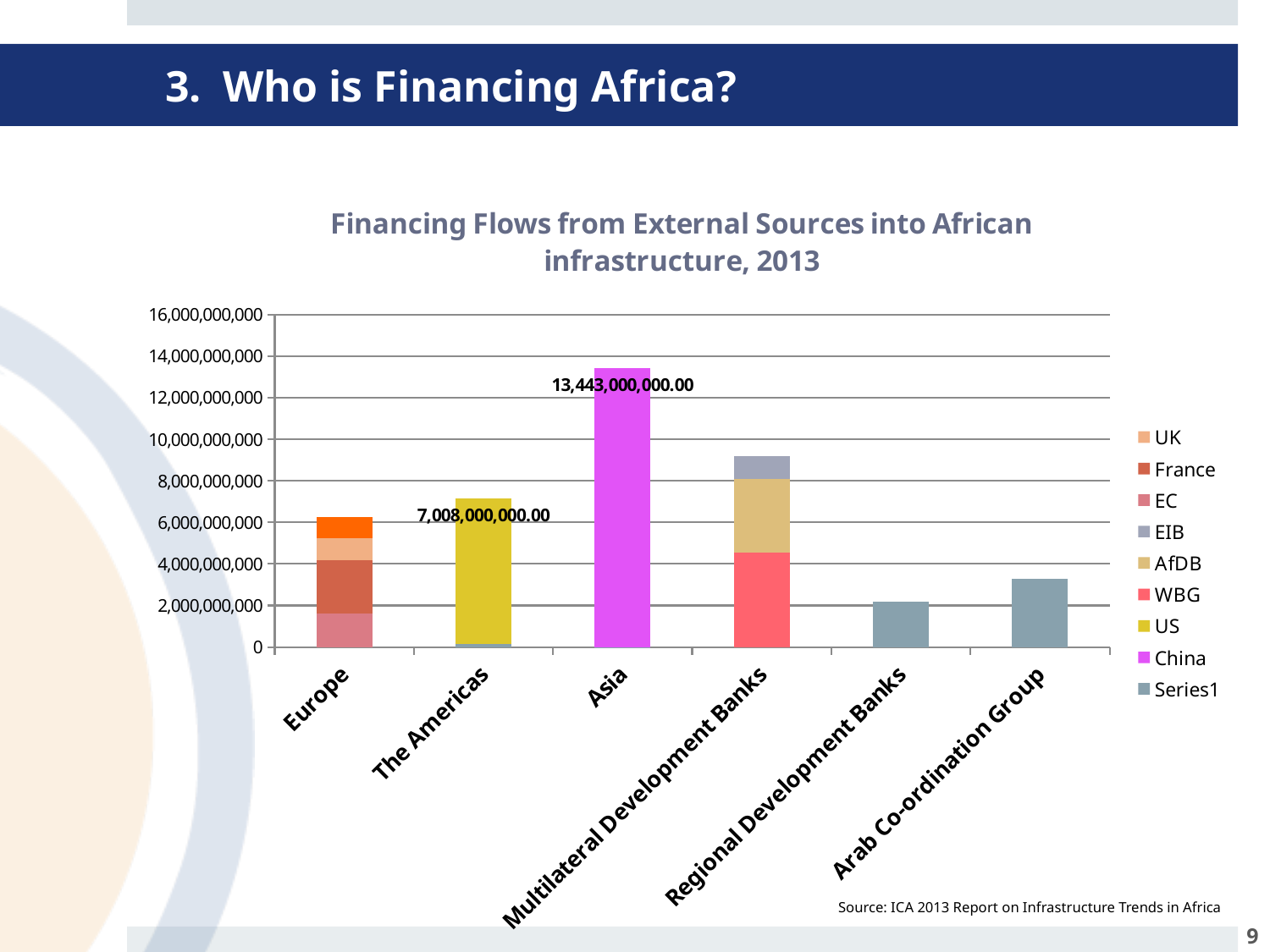
How many series does the legend list? 9 What is the data label shown on the Asia bar? 13,443,000,000.00 What is the difference between the labelled value for Asia and the labelled value for The Americas? 6,435,000,000.00 Which bar is taller, Europe or Arab Co-ordination Group? Europe What is the data label shown on The Americas bar? 7,008,000,000.00 How many categories are shown on the x axis? 6 Which category has the shortest bar? Regional Development Banks What type of chart is shown on the slide? Stacked bar chart Which category has the tallest bar? Asia Which bar is taller, Asia or Multilateral Development Banks? Asia Is the value for Arab Co-ordination Group greater or less than 4,000,000,000? less Is the total value for Multilateral Development Banks greater or less than 8,000,000,000? greater